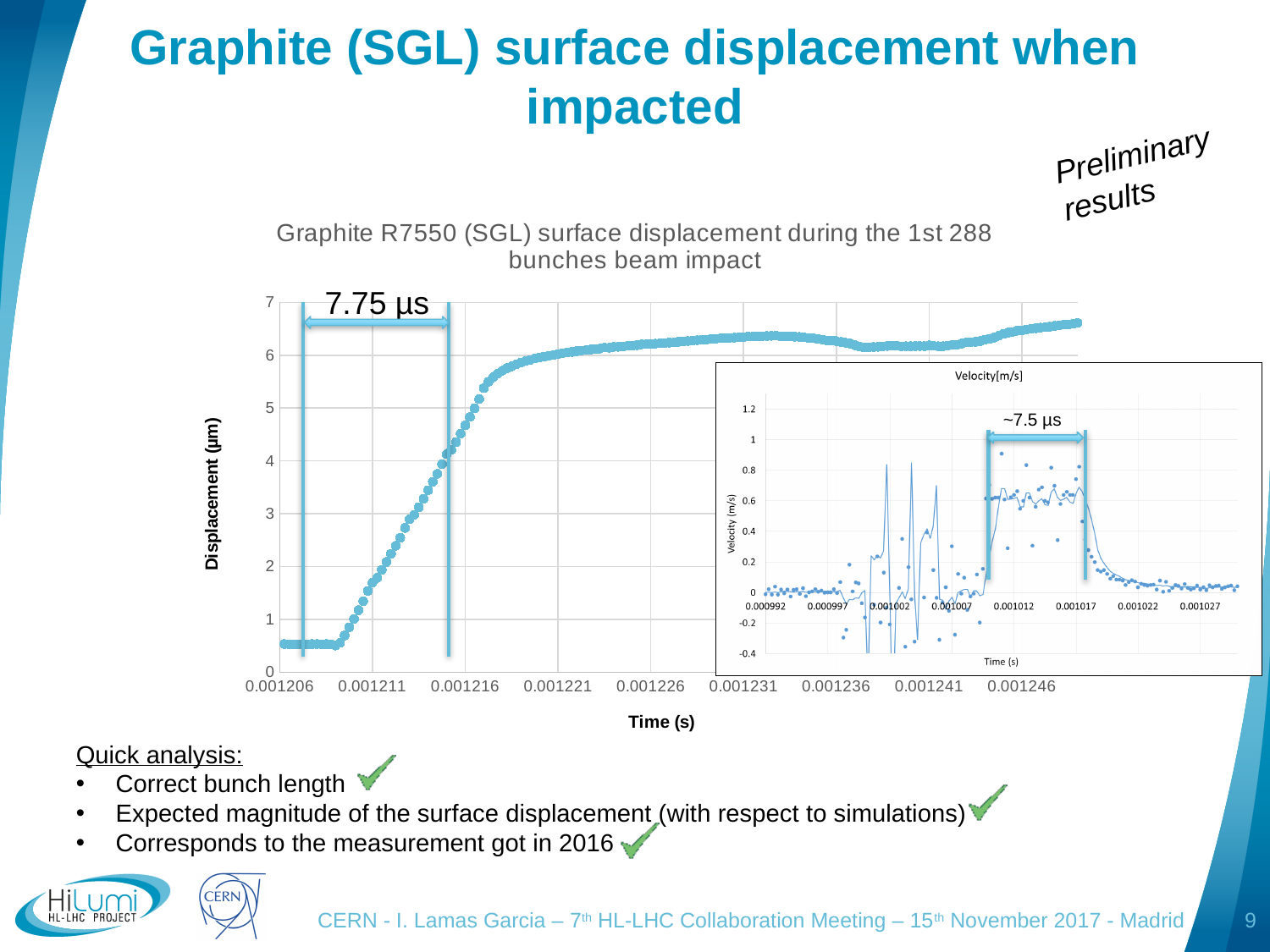
In the inset velocity chart, is the velocity at time 0.001027 greater or less than 0.2? less In the inset velocity chart, what is the lowest value shown on the y axis? -0.4 In the main displacement chart, what is the first tick value on the x axis? 0.001206 In the main displacement chart, does the displacement rise or fall as time increases from 0.001206 to 0.001221? rise In the main displacement chart, what time interval is annotated between the two vertical lines? 7.75 µs In the main displacement chart, what is the highest value shown on the y axis? 7 What is the title of the main chart on the slide? Graphite R7550 (SGL) surface displacement during the 1st 288 bunches beam impact In the main displacement chart, is the displacement at time 0.001231 greater or less than 6? greater What kind of chart is the main displacement chart? scatter chart In the main displacement chart, is the displacement at time 0.001206 greater or less than 1? less In the inset velocity chart, what time interval is annotated above the plateau? ~7.5 µs In the main displacement chart, what is the label of the y axis? Displacement (µm)